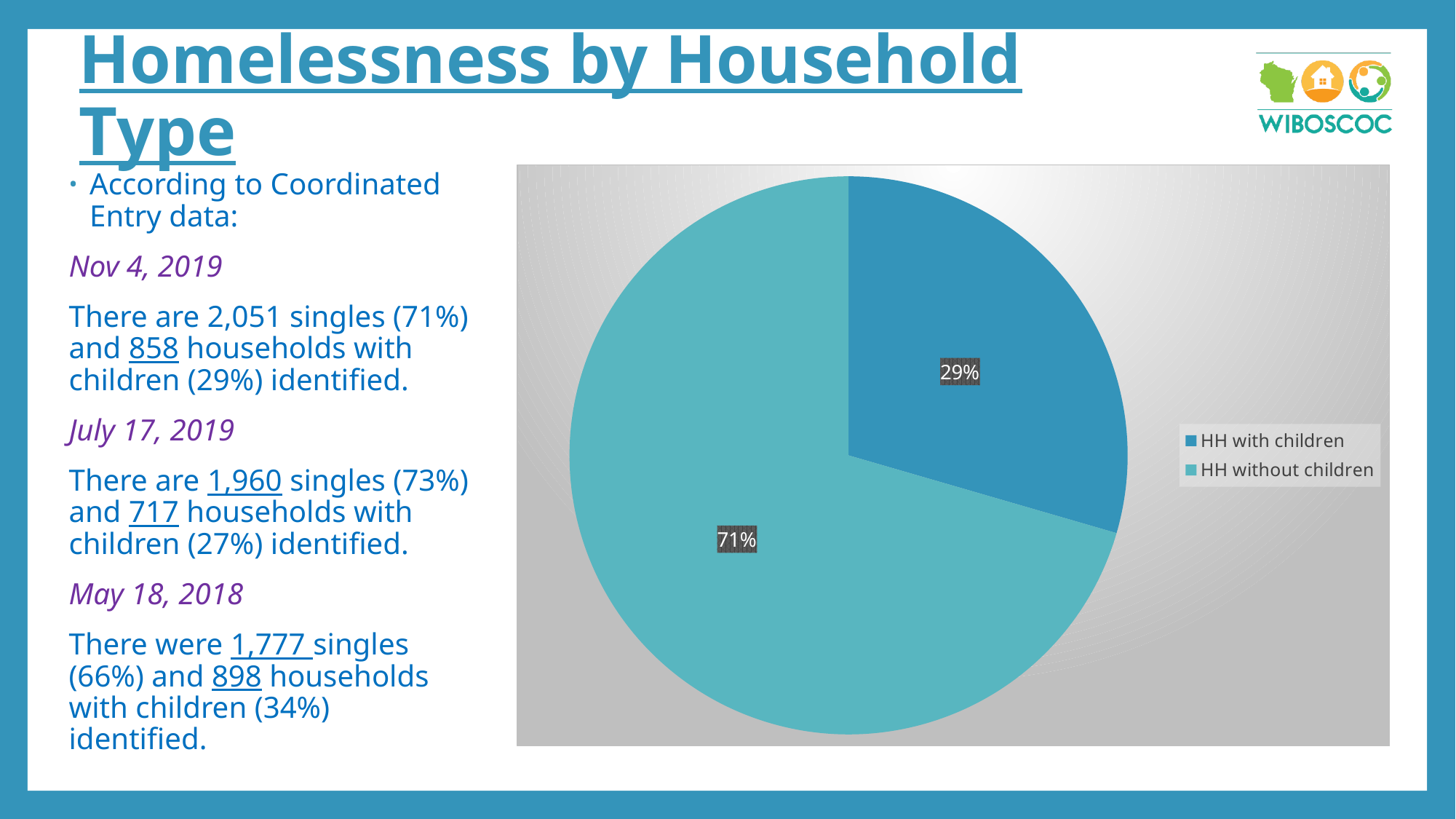
Which slice of the pie chart is the smallest? HH with children Which slice of the pie chart is the largest? HH without children What share of the pie is labelled for HH without children? 71% What type of chart is shown on the slide? pie chart How many entries does the legend of the pie chart list? 2 Which is larger in the pie chart, HH with children or HH without children? HH without children What is the difference in percentage points between the HH without children slice and the HH with children slice? 42 What share of the pie is labelled for HH with children? 29% Which legend entry is shown in the darker blue colour? HH with children What are the two legend entries of the pie chart? HH with children, HH without children How many slices does the pie chart have? 2